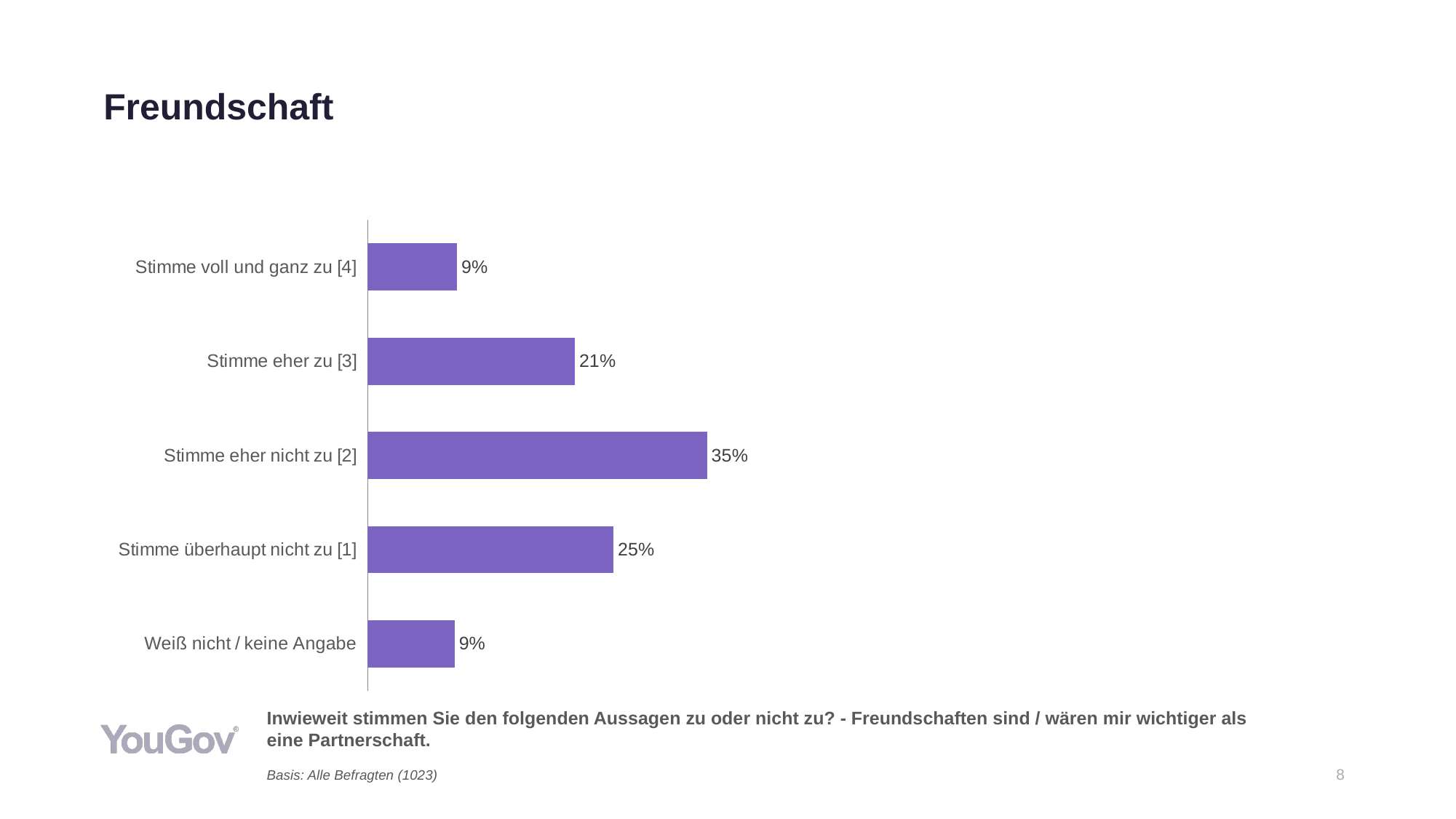
What percentage of respondents answered "Stimme eher nicht zu [2]"? 35% What is the value for "Weiß nicht / keine Angabe"? 9% What is the title of the slide? Freundschaft What is the difference between "Stimme eher nicht zu [2]" and "Stimme überhaupt nicht zu [1]"? 10% Which is larger, "Stimme eher zu [3]" or "Stimme überhaupt nicht zu [1]"? Stimme überhaupt nicht zu [1] How many categories are shown in the chart? 5 What is the difference between "Stimme eher zu [3]" and "Stimme voll und ganz zu [4]"? 12% What is the base (Basis) stated below the chart? Alle Befragten (1023) What percentage is shown for "Stimme überhaupt nicht zu [1]"? 25% What is the value shown for "Stimme eher zu [3]"? 21% What kind of chart is shown on the slide? Bar chart Which category has the highest value? Stimme eher nicht zu [2]